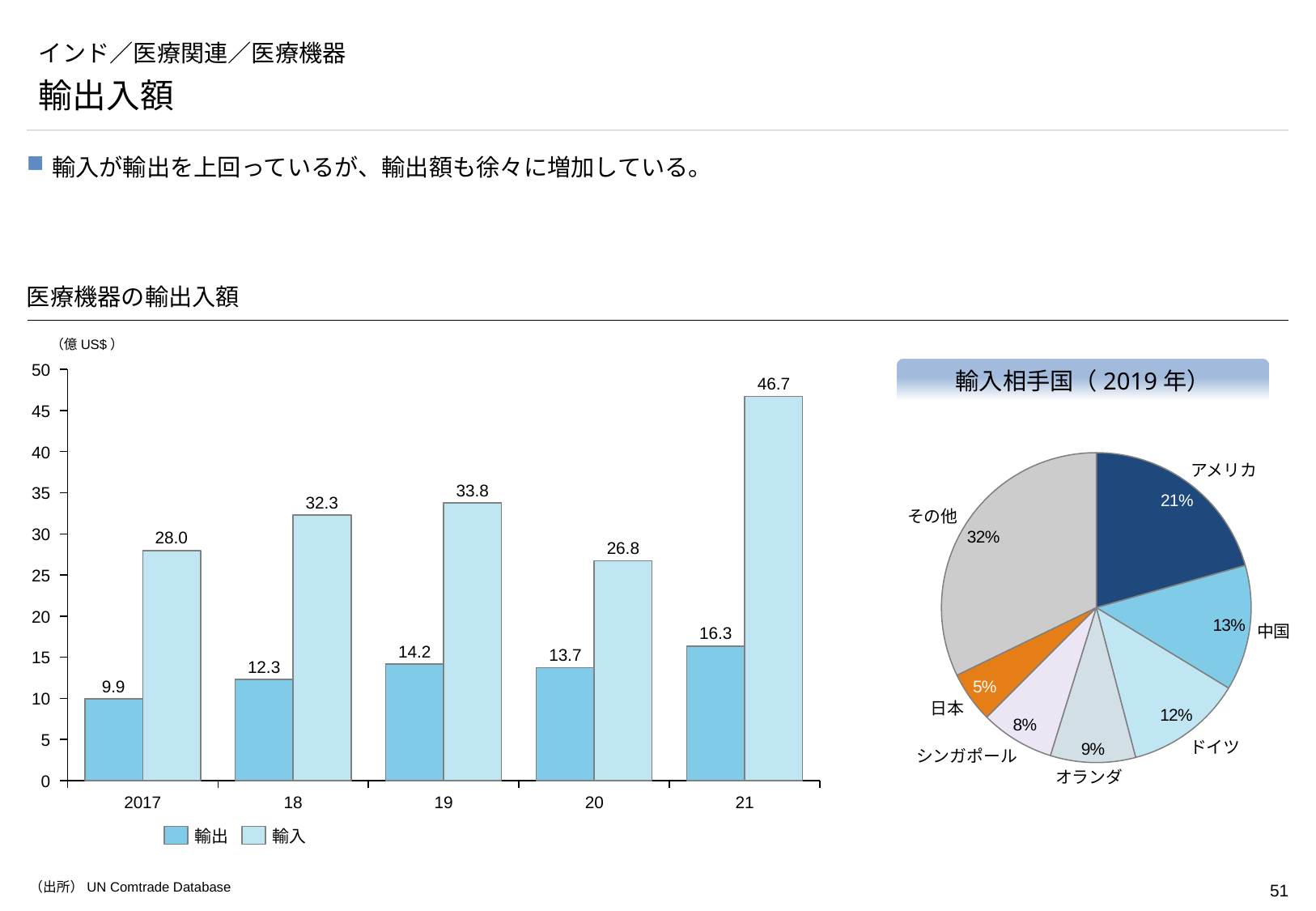
In the bar chart 医療機器の輸出入額, what is the difference between 輸入 and 輸出 in 2019? 19.6 In the bar chart 医療機器の輸出入額, what is the value of 輸出 in 2017? 9.9 In the pie chart 輸入相手国（2019年）, what share does アメリカ have? 21% In the bar chart 医療機器の輸出入額, which year has the highest 輸入 value? 21 In the bar chart 医療機器の輸出入額, how many series does the legend list? 2 In the bar chart 医療機器の輸出入額, how many years are shown on the x axis? 5 In the bar chart 医療機器の輸出入額, which is larger in 2020, 輸出 or 輸入? 輸入 In the pie chart 輸入相手国（2019年）, which named country has the smallest share? 日本 In the bar chart 医療機器の輸出入額, what is the value of 輸入 in 2021? 46.7 What kind of chart is 輸入相手国（2019年）? pie chart In the pie chart 輸入相手国（2019年）, how many slices are there? 7 In the bar chart 医療機器の輸出入額, which year has the lowest 輸出 value? 2017